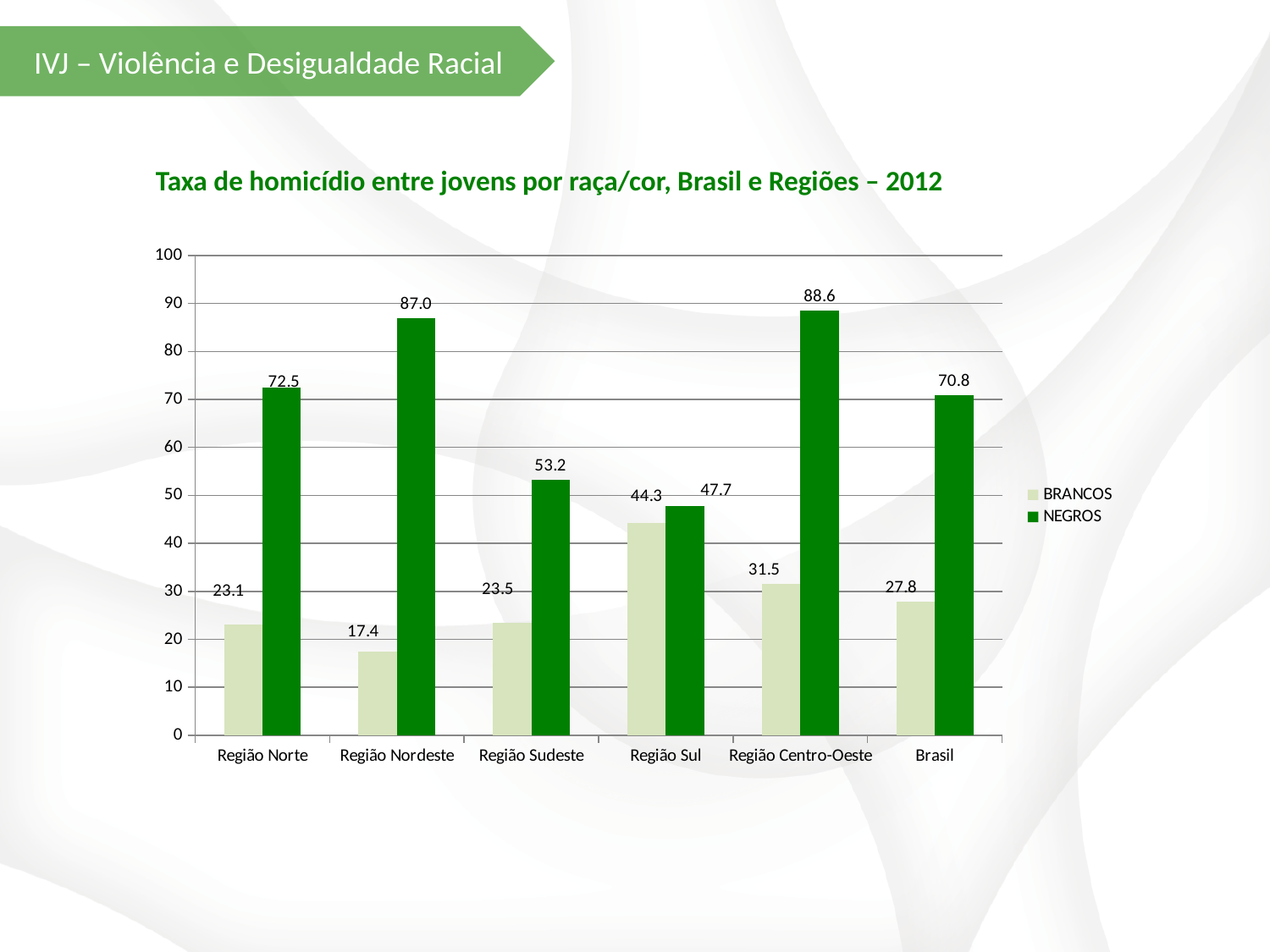
What is the difference between the NEGROS and BRANCOS values in Região Norte? 49.4 Which is larger in Região Sudeste: the value for BRANCOS or the value for NEGROS? NEGROS Is the value for NEGROS in Brasil greater or less than 60? greater How many categories are shown on the x axis? 6 How many series does the legend list? 2 Which category has the lowest value for BRANCOS? Região Nordeste Which category has the highest value for NEGROS? Região Centro-Oeste What is the title of the chart? Taxa de homicídio entre jovens por raça/cor, Brasil e Regiões – 2012 What is the value for BRANCOS in Região Sul? 44.3 What kind of chart is shown on the slide? bar chart What is the value for BRANCOS in Brasil? 27.8 What is the value for NEGROS in Região Nordeste? 87.0